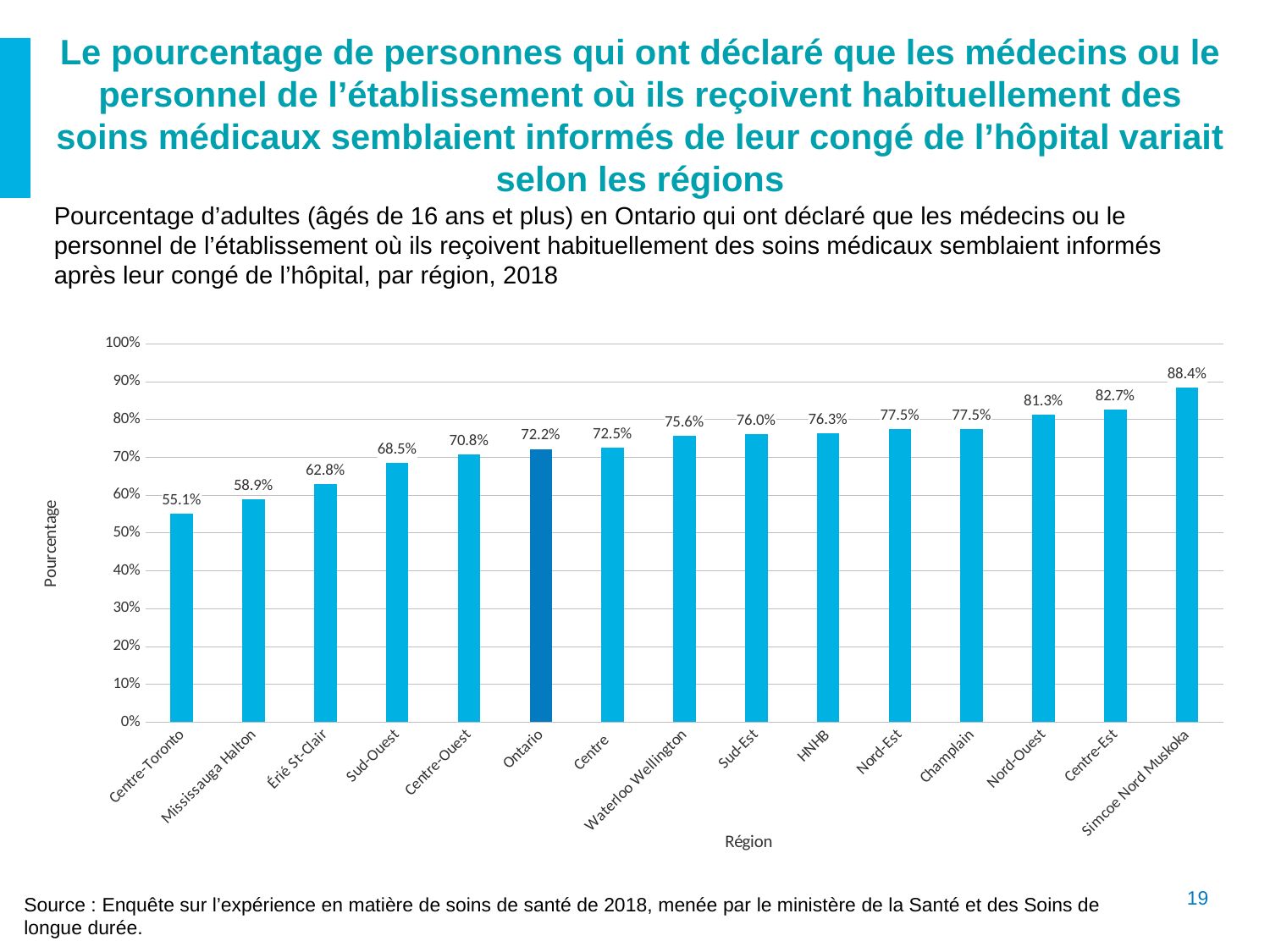
Which is larger, the value for Sud-Ouest or the value for Champlain? Champlain What is the difference between Simcoe Nord Muskoka and Centre-Toronto? 33.3% What is the value for Nord-Ouest? 81.3% What is the label of the vertical axis? Pourcentage Is the value for Mississauga Halton greater or less than 60%? less Which region has the lowest value? Centre-Toronto Which region has the highest value? Simcoe Nord Muskoka What is the difference between Centre-Est and Ontario? 10.5% What kind of chart is shown on the slide? bar chart What is the value for Centre-Toronto? 55.1% What is the value for Ontario? 72.2% How many bars are shown in the chart? 15